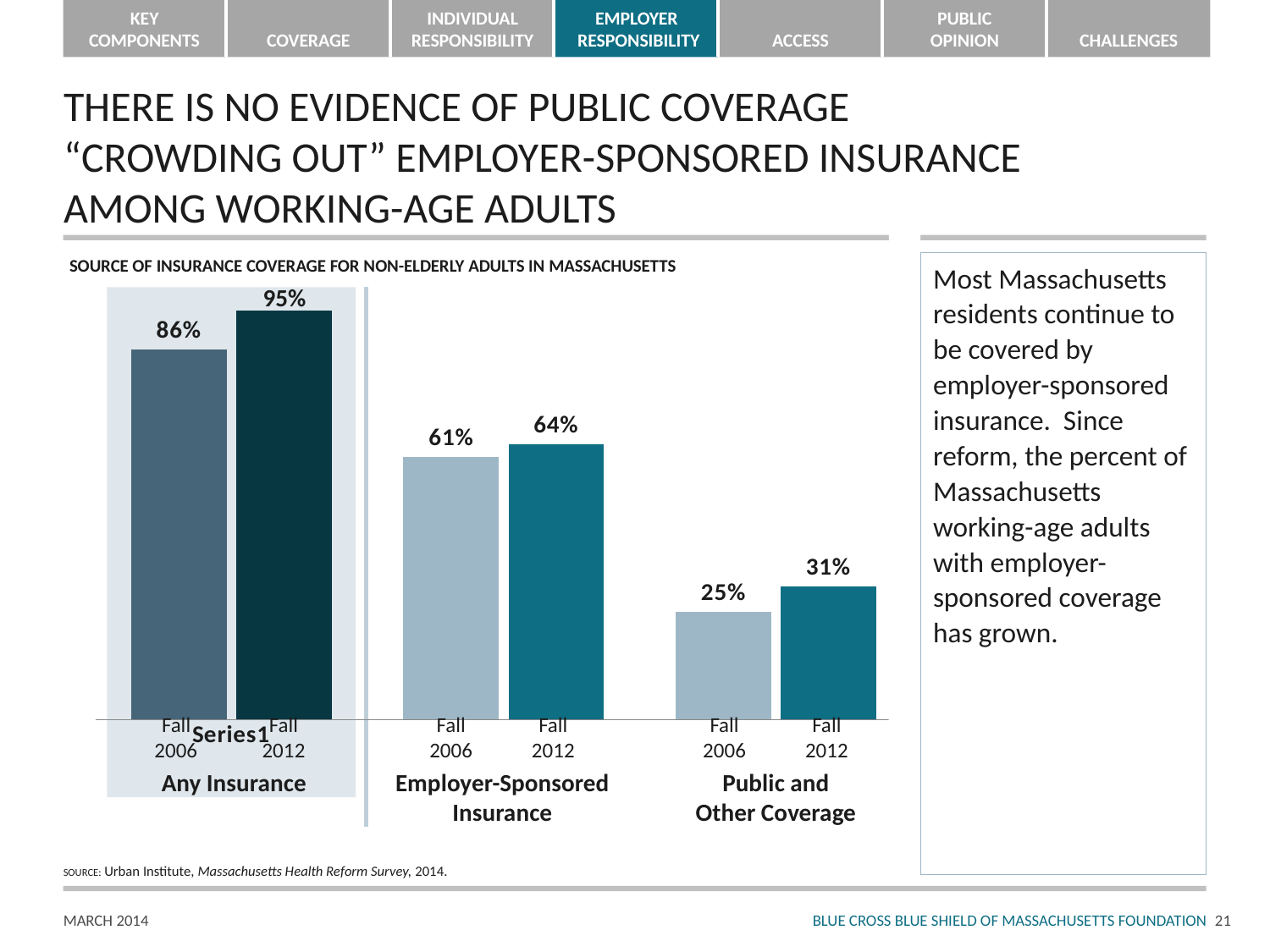
By how many percentage points did Any Insurance coverage change from Fall 2006 to Fall 2012? 9 percentage points Which bar has the highest value on the chart? Any Insurance, Fall 2012 What is the value for Any Insurance in Fall 2006? 86% What is the value for Any Insurance in Fall 2012? 95% What is the difference between the Fall 2012 values for Employer-Sponsored Insurance and Public and Other Coverage? 33 percentage points How many bars are plotted on the chart? 6 What is the value for Public and Other Coverage in Fall 2012? 31% What is the value for Employer-Sponsored Insurance in Fall 2006? 61% What is the title of the chart? Source of Insurance Coverage for Non-Elderly Adults in Massachusetts What kind of chart is shown on the slide? Bar chart Which bar has the lowest value on the chart? Public and Other Coverage, Fall 2006 Which is larger: Employer-Sponsored Insurance in Fall 2012 or Public and Other Coverage in Fall 2012? Employer-Sponsored Insurance in Fall 2012